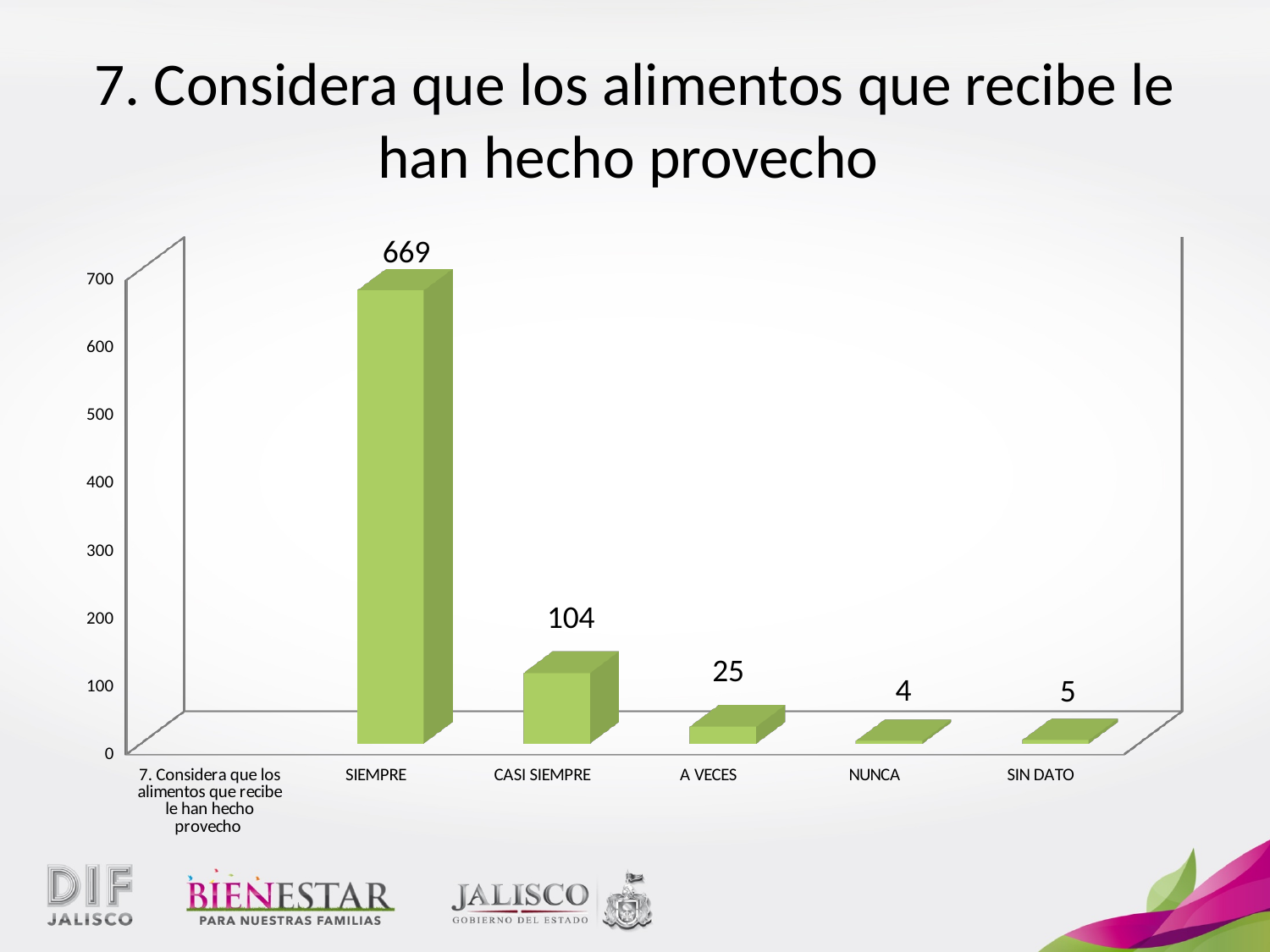
Which category has the highest value? SIEMPRE What is the value for CASI SIEMPRE? 104 What is the value for A VECES? 25 What is the value for SIN DATO? 5 What is the value for SIEMPRE? 669 What is the difference between the values for SIEMPRE and CASI SIEMPRE? 565 Is the value for SIEMPRE greater or less than 600? greater Which is larger, the value for SIN DATO or the value for NUNCA? SIN DATO Which category has the lowest value? NUNCA What is the value for NUNCA? 4 What kind of chart is shown on the slide? bar chart How many bars are plotted in the chart? 5